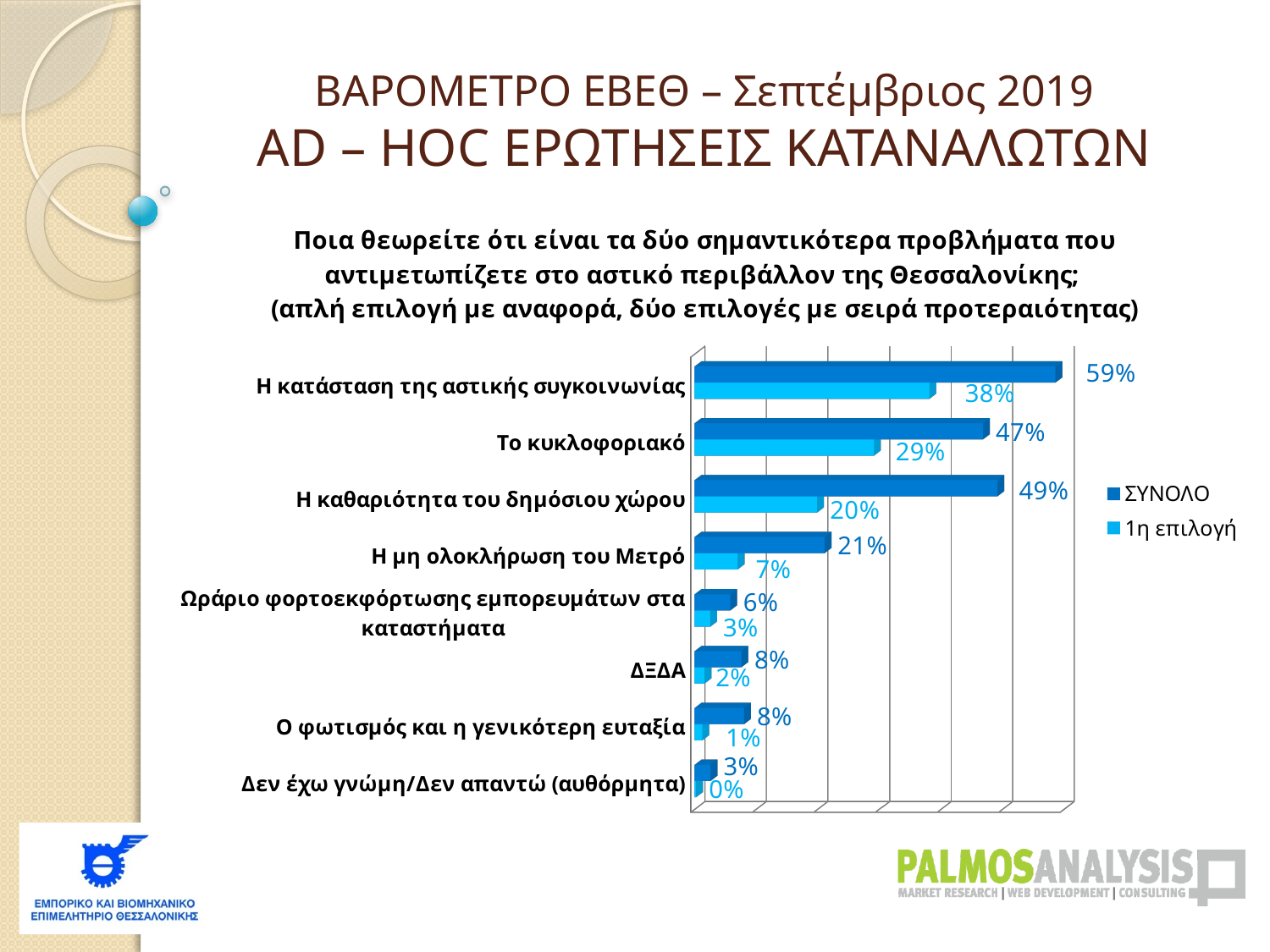
What is the ΣΥΝΟΛΟ value for "Η κατάσταση της αστικής συγκοινωνίας"? 59% What is the 1η επιλογή value for "Η μη ολοκλήρωση του Μετρό"? 7% What is the 1η επιλογή value for "Το κυκλοφοριακό"? 29% Which category has the lowest 1η επιλογή value? Δεν έχω γνώμη/Δεν απαντώ (αυθόρμητα) Which is larger: the ΣΥΝΟΛΟ value for "Το κυκλοφοριακό" or for "Η καθαριότητα του δημόσιου χώρου"? Η καθαριότητα του δημόσιου χώρου What is the ΣΥΝΟΛΟ value for "Η καθαριότητα του δημόσιου χώρου"? 49% What kind of chart is shown on the slide? Bar chart How many categories are shown in the chart? 8 What is the difference between the ΣΥΝΟΛΟ and 1η επιλογή values for "Η κατάσταση της αστικής συγκοινωνίας"? 21% Which category has the highest ΣΥΝΟΛΟ value? Η κατάσταση της αστικής συγκοινωνίας What are the two series named in the legend? ΣΥΝΟΛΟ and 1η επιλογή How many series does the legend list? 2